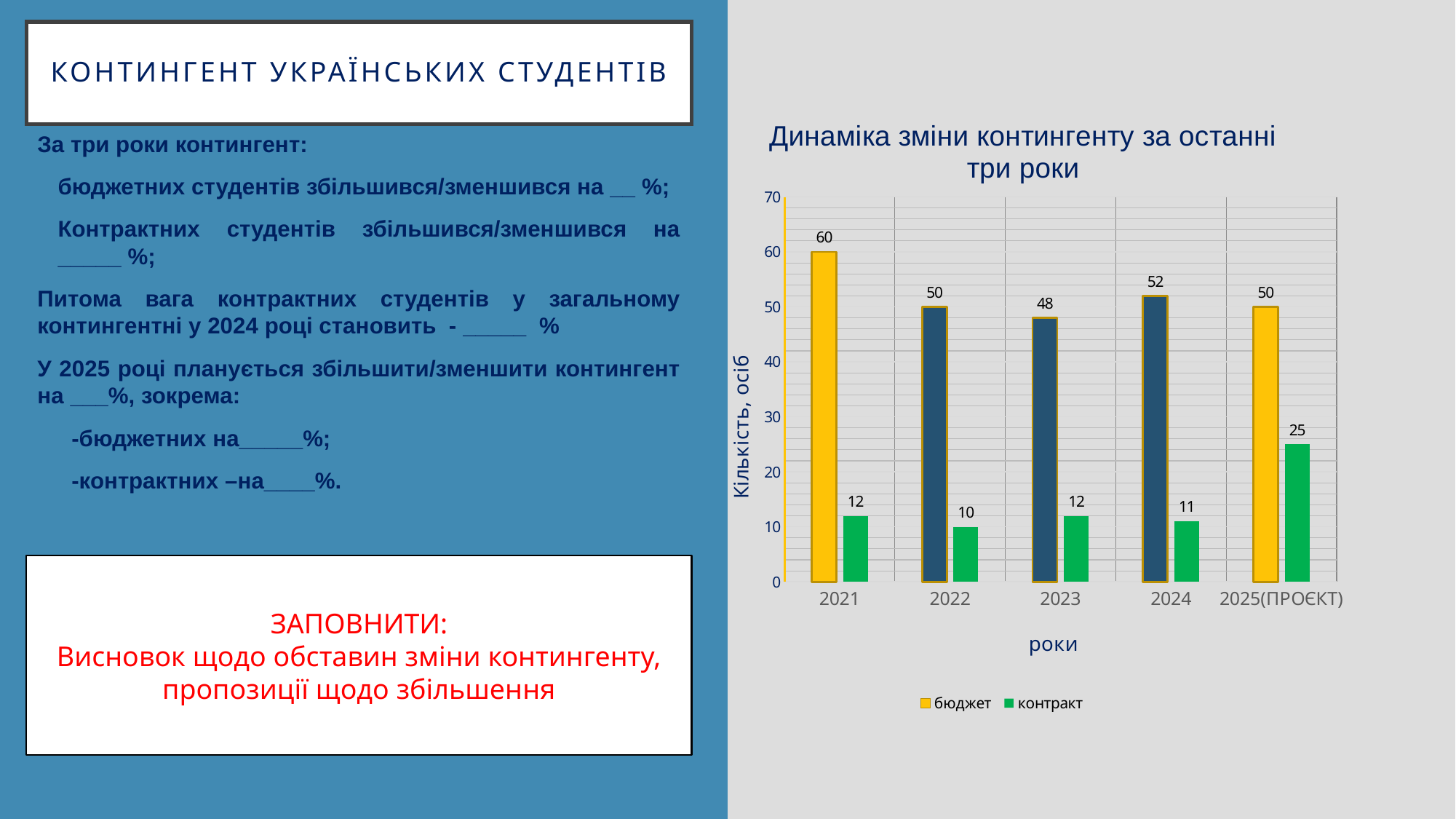
In which year is the контракт value lowest? 2022 How many years (categories) are shown on the x axis? 5 How many series does the legend list? 2 In which year is the бюджет value highest? 2021 What is the difference between the бюджет and контракт values in 2024? 41 Which is larger: the контракт value in 2023 or in 2025(ПРОЄКТ)? 2025(ПРОЄКТ) What is the value for контракт in 2025(ПРОЄКТ)? 25 What is the value for бюджет in 2021? 60 What is the value for бюджет in 2023? 48 What is the title of the chart? Динаміка зміни контингенту за останні три роки What is the value for контракт in 2024? 11 What kind of chart is shown on the slide? bar chart